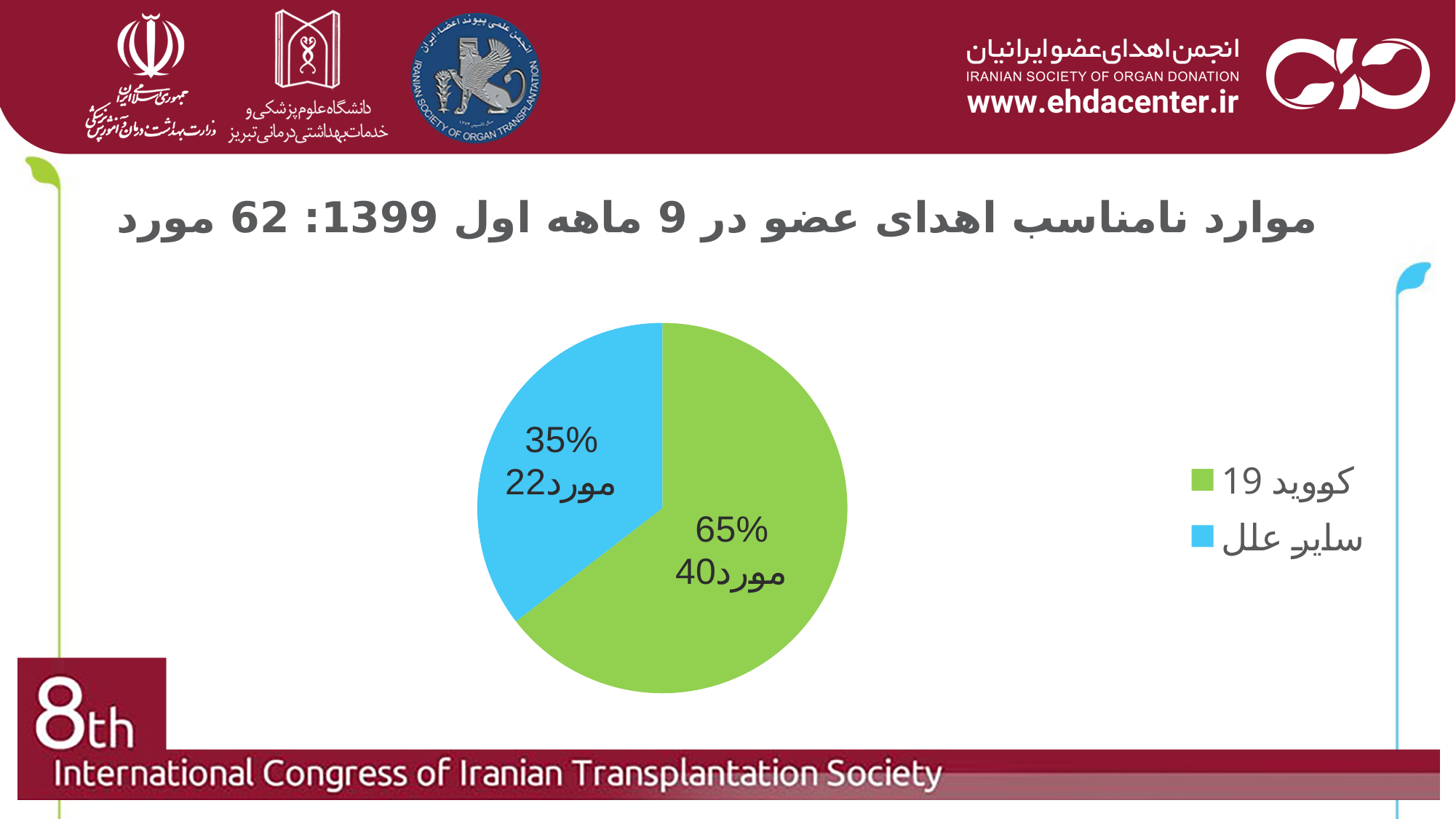
Which slice of the pie chart is the largest? کووید 19 What is the total number of cases across both slices of the pie chart? 62 How many cases (مورد) are shown for the "سایر علل" (other causes) slice? 22 مورد What percentage of the pie does the "کووید 19" (COVID-19) slice represent? 65% What percentage of the pie does the "سایر علل" (other causes) slice represent? 35% What colour is the "سایر علل" (other causes) slice in the pie chart? Blue What kind of chart is shown on the slide? Pie chart How many slices does the pie chart have? 2 Which slice of the pie chart is the smallest? سایر علل How many cases (مورد) are shown for the "کووید 19" (COVID-19) slice? 40 مورد What is the difference in number of cases between the "کووید 19" slice and the "سایر علل" slice? 18 Which has more cases, "کووید 19" or "سایر علل"? کووید 19